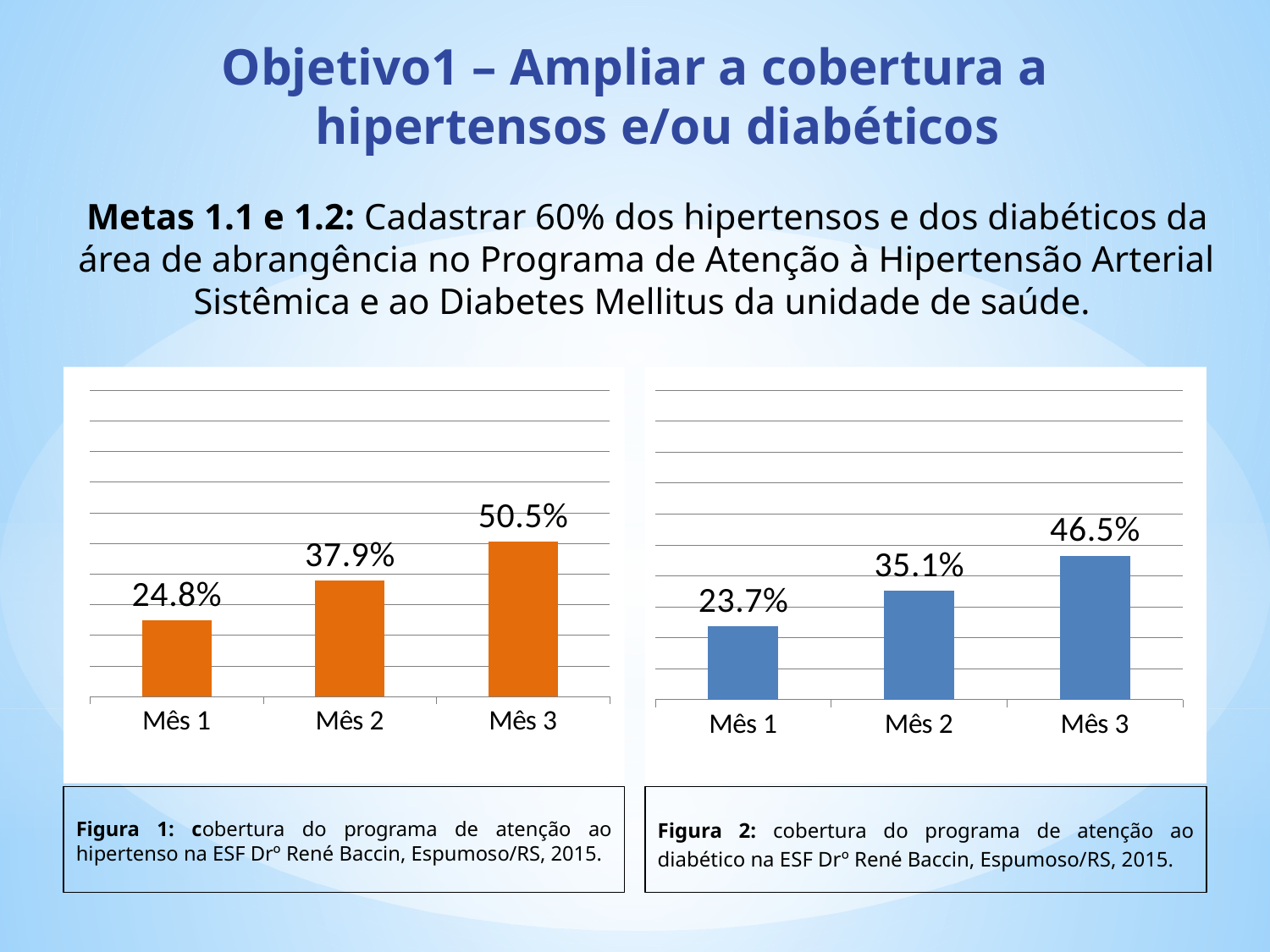
How many categories (months) are shown in the left chart (Figura 1)? 3 In the left chart (Figura 1), which month has the highest coverage? Mês 3 In the right chart (Figura 2, diabetes coverage), what is the value for Mês 3? 46.5% Which is larger: the Mês 3 value in the left chart (Figura 1) or the Mês 3 value in the right chart (Figura 2)? Left chart (Figura 1), 50.5% In the right chart (Figura 2), what is the difference between the values for Mês 2 and Mês 1? 11.4% In the right chart (Figura 2), which month has the lowest coverage? Mês 1 In the left chart (Figura 1), what is the difference between the values for Mês 3 and Mês 1? 25.7% In the left chart (Figura 1), what is the value for Mês 1? 24.8% What kind of chart is the right chart (Figura 2)? Bar chart What colour are the bars in the left chart (Figura 1)? Orange In the left chart (Figura 1, hypertension coverage), what is the value for Mês 2? 37.9% In the right chart (Figura 2), do the values rise or fall from Mês 1 to Mês 3? Rise